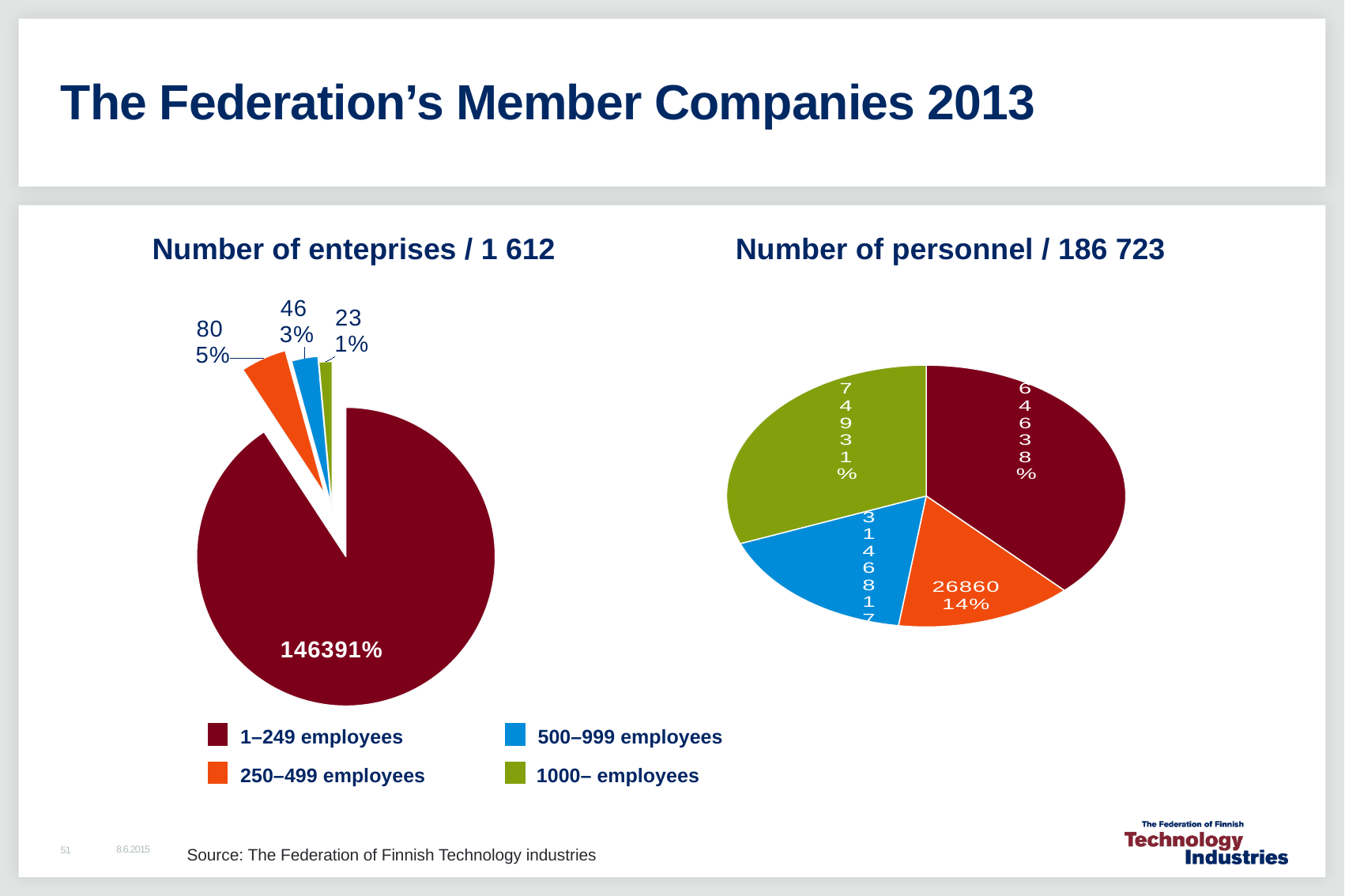
In the 'Number of personnel / 186 723' chart, how many personnel are in companies with 250–499 employees? 26860 In the 'Number of enteprises / 1 612' chart, what is the difference between the number of enterprises with 250–499 employees and those with 500–999 employees? 34 In the 'Number of personnel / 186 723' chart, which size category has the largest slice? 1–249 employees In the 'Number of enteprises / 1 612' chart, which size category has the smallest slice? 1000– employees In the 'Number of enteprises / 1 612' chart, what share of the pie do enterprises with 1000– employees make up? 1% In the 'Number of personnel / 186 723' chart, what share of the pie do companies with 250–499 employees make up? 14% How many slices does the 'Number of enteprises / 1 612' pie chart have? 4 In the 'Number of enteprises / 1 612' chart, which size category has the largest slice? 1–249 employees In the 'Number of enteprises / 1 612' chart, how many enterprises have 250–499 employees? 80 In the 'Number of enteprises / 1 612' chart, how many enterprises have 500–999 employees? 46 In the 'Number of enteprises / 1 612' chart, what share of the pie do enterprises with 250–499 employees make up? 5% What kind of chart is the 'Number of enteprises / 1 612' chart? pie chart